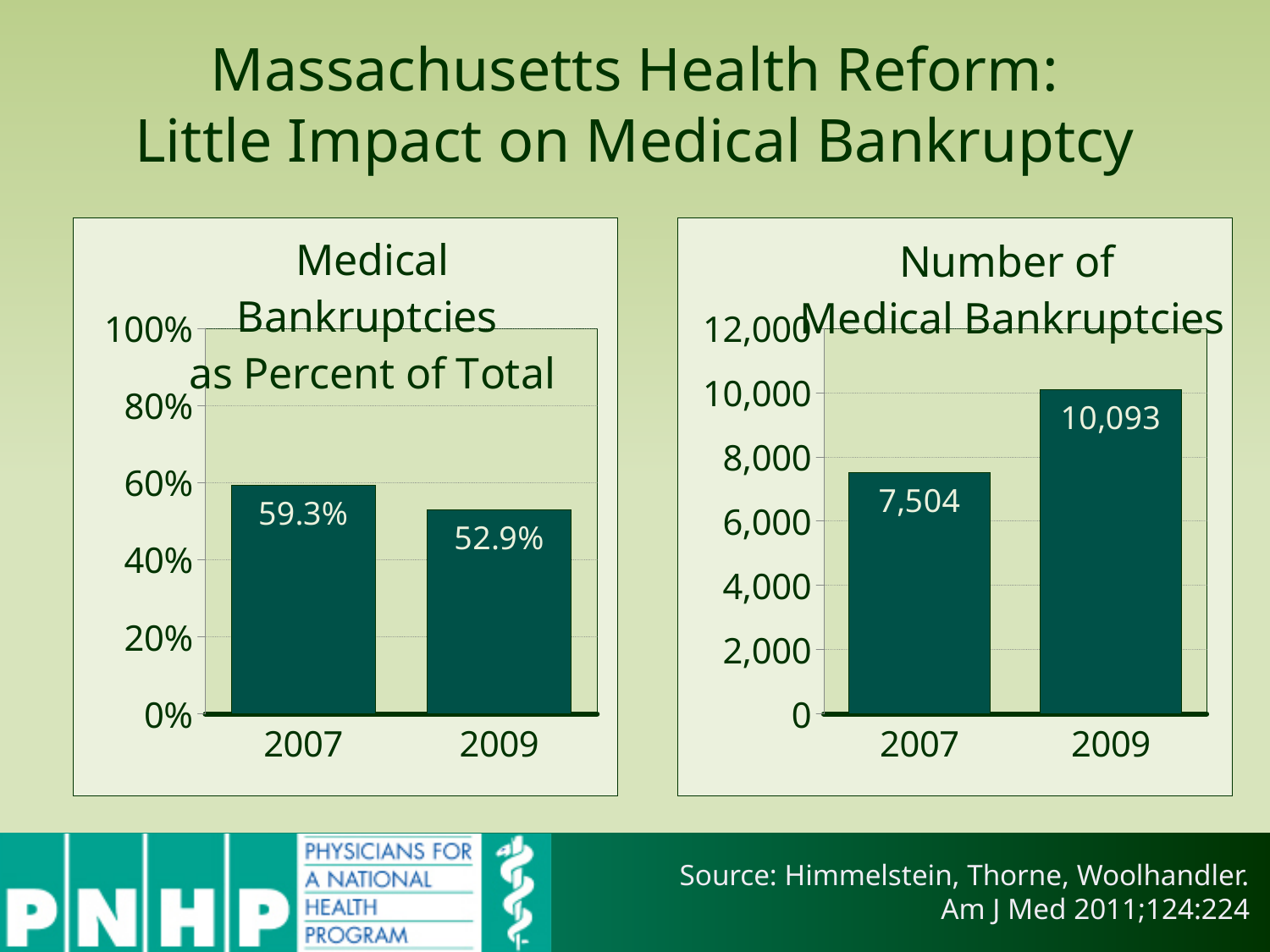
How many categories are shown on the x axis of the left chart (Medical Bankruptcies as Percent of Total)? 2 In the right chart (Number of Medical Bankruptcies), what is the value for 2009? 10,093 In the right chart (Number of Medical Bankruptcies), what is the value for 2007? 7,504 In the left chart (Medical Bankruptcies as Percent of Total), which year has the higher value? 2007 In the right chart (Number of Medical Bankruptcies), is the value for 2009 greater or less than 10,000? greater In the left chart (Medical Bankruptcies as Percent of Total), what is the difference between the 2007 and 2009 values? 6.4% In the left chart (Medical Bankruptcies as Percent of Total), what is the value for 2009? 52.9% In the right chart (Number of Medical Bankruptcies), which year has the lower value? 2007 In the right chart (Number of Medical Bankruptcies), what is the difference between the 2009 and 2007 values? 2,589 What kind of chart is the right chart (Number of Medical Bankruptcies)? bar chart In the right chart (Number of Medical Bankruptcies), do the values rise or fall from 2007 to 2009? rise In the left chart (Medical Bankruptcies as Percent of Total), what is the value for 2007? 59.3%